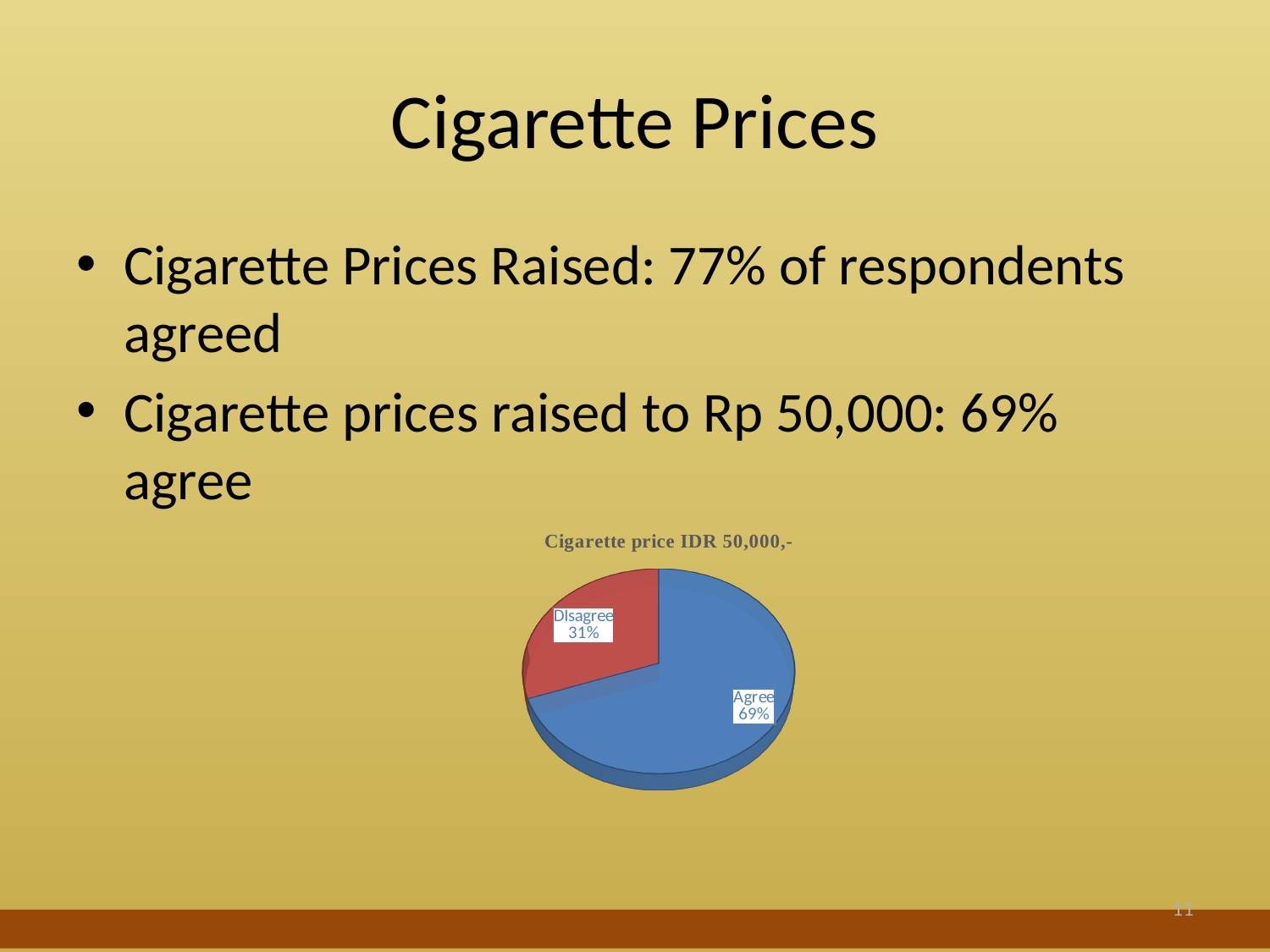
What is the title of the pie chart? Cigarette price IDR 50,000,- Which slice of the pie chart is the largest? Agree What is the difference in percentage points between the Agree and Disagree slices? 38 Is the Disagree share of the pie chart greater or less than 50%? less How many slices does the pie chart have? 2 What colour is the Agree slice of the pie chart? blue Which is larger in the pie chart, Agree or Disagree? Agree What type of chart is shown on the slide? pie chart What percentage of the pie chart is labelled Disagree? 31% What percentage of the pie chart is labelled Agree? 69% Which slice of the pie chart is the smallest? Disagree